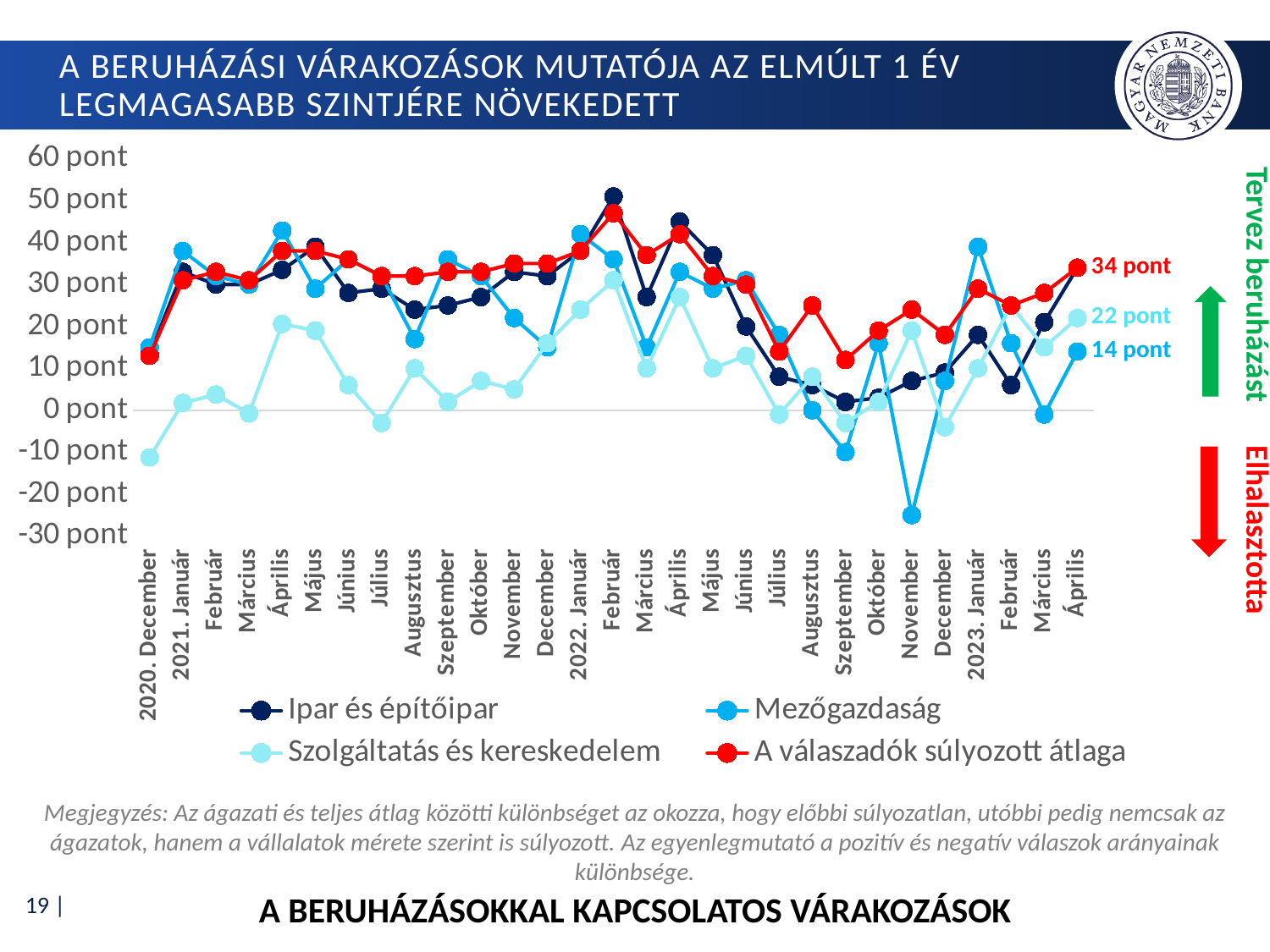
What kind of chart is shown on the slide? line chart Is the value for 'Mezőgazdaság' in 2022. November greater or less than -20 pont? less In which month does the 'Mezőgazdaság' series reach its lowest value? 2022. November How many series does the legend list? 4 What is the value of 'Szolgáltatás és kereskedelem' in 2023. Április? 22 pont What is the value of 'A válaszadók súlyozott átlaga' in 2023. Április? 34 pont Is the value for 'Ipar és építőipar' in 2022. Február greater or less than 40 pont? greater In 2023. Április, which is larger: 'A válaszadók súlyozott átlaga' or 'Szolgáltatás és kereskedelem'? A válaszadók súlyozott átlaga In 2023. Április, what is the difference between 'A válaszadók súlyozott átlaga' and 'Mezőgazdaság'? 20 pont How many months (data points) are shown on the x axis? 29 What is the value of 'Mezőgazdaság' in 2023. Április? 14 pont Which series is drawn in red? A válaszadók súlyozott átlaga